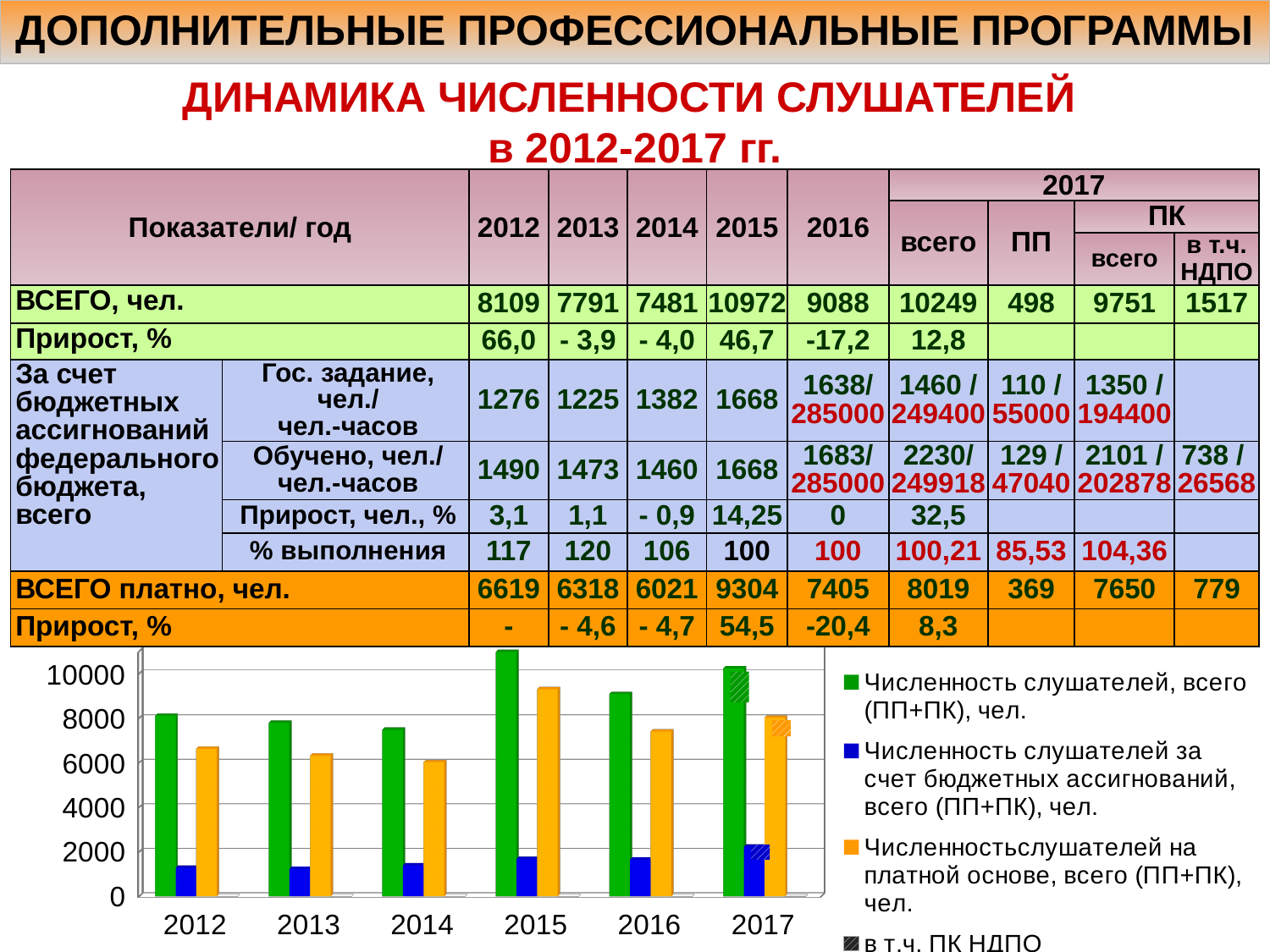
In 2016, which is larger: the green bar or the orange bar? the green bar Is the orange bar for 2016 greater or less than 8000? less In the bar chart, which year has the shortest green bar (Численность слушателей, всего)? 2014 In the bar chart, which year has the tallest orange bar (Численность слушателей на платной основе)? 2015 Which colour in the bar chart represents Численность слушателей на платной основе, всего (ПП+ПК), чел.? orange How many entries does the legend of the bar chart list? 4 Is the green bar for 2015 greater or less than 10000? greater What kind of chart is shown at the bottom of the slide? bar chart How many years are shown on the x axis of the bar chart? 6 Is the blue bar for 2012 greater or less than 2000? less Do the green bars rise or fall from 2012 to 2014? fall In the bar chart, which year has the tallest green bar (Численность слушателей, всего)? 2015